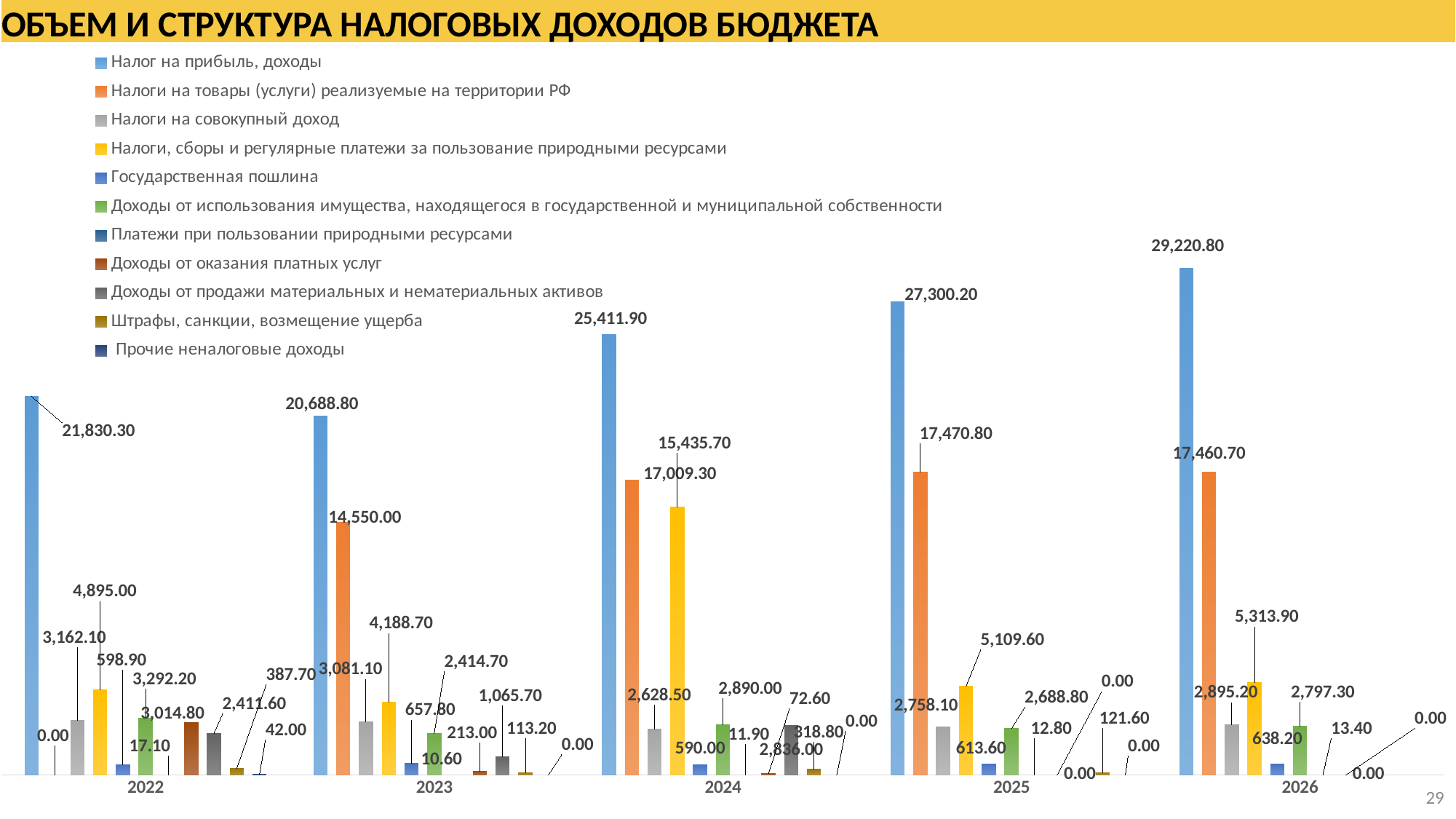
What is the value of 'Налог на прибыль, доходы' for 2026? 29,220.80 How many series does the legend list? 11 What is the title of the chart on the slide? ОБЪЕМ И СТРУКТУРА НАЛОГОВЫХ ДОХОДОВ БЮДЖЕТА Does 'Налог на прибыль, доходы' rise or fall from 2023 to 2026? rise In which year is 'Налог на прибыль, доходы' the lowest? 2023 What is the value of 'Налоги, сборы и регулярные платежи за пользование природными ресурсами' for 2024? 15,435.70 Which year has the larger value for 'Налоги на товары (услуги) реализуемые на территории РФ': 2023 or 2024? 2024 How many years are shown on the x axis? 5 What is the difference between the 'Налог на прибыль, доходы' values for 2026 and 2025? 1,920.60 What kind of chart is shown on the slide? bar chart What is the value of 'Налоги на товары (услуги) реализуемые на территории РФ' for 2023? 14,550.00 In which year is 'Налог на прибыль, доходы' the highest? 2026